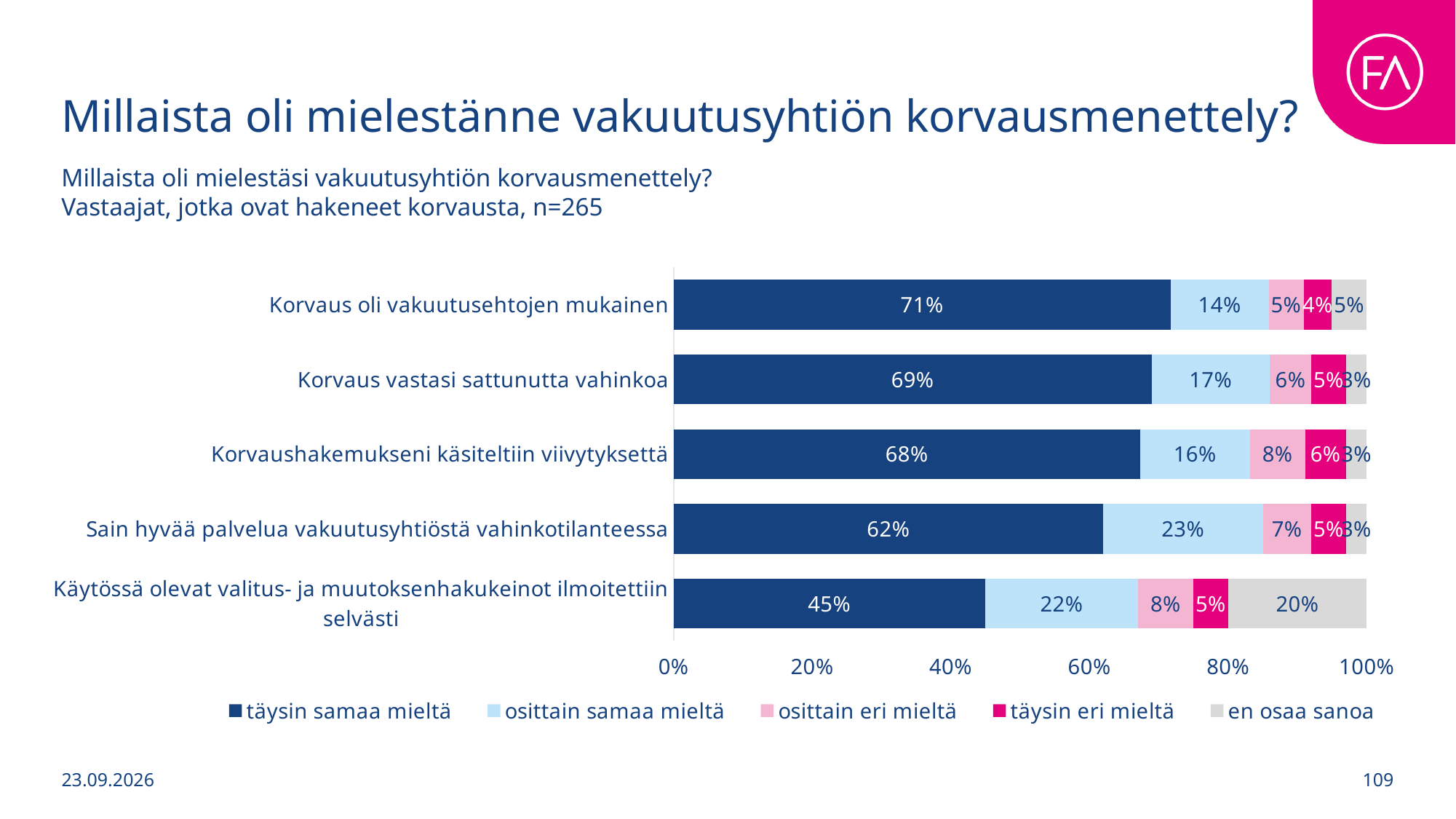
How many categories (statements) are plotted in the chart? 5 What is the 'osittain samaa mieltä' value for 'Sain hyvää palvelua vakuutusyhtiöstä vahinkotilanteessa'? 23% Which is larger: the 'osittain samaa mieltä' value for 'Korvaus vastasi sattunutta vahinkoa' or for 'Sain hyvää palvelua vakuutusyhtiöstä vahinkotilanteessa'? Sain hyvää palvelua vakuutusyhtiöstä vahinkotilanteessa What is the 'en osaa sanoa' value for 'Käytössä olevat valitus- ja muutoksenhakukeinot ilmoitettiin selvästi'? 20% What is the 'osittain eri mieltä' value for 'Korvaushakemukseni käsiteltiin viivytyksettä'? 8% How many series does the legend list? 5 Which statement has the lowest 'täysin samaa mieltä' share? Käytössä olevat valitus- ja muutoksenhakukeinot ilmoitettiin selvästi What colour represents 'täysin eri mieltä' in the legend? magenta (pink-red) What is the 'täysin samaa mieltä' value for 'Korvaus oli vakuutusehtojen mukainen'? 71% What is the difference between the 'täysin samaa mieltä' values for 'Korvaus oli vakuutusehtojen mukainen' and 'Käytössä olevat valitus- ja muutoksenhakukeinot ilmoitettiin selvästi'? 26 percentage points What kind of chart is shown on the slide? stacked bar chart Which statement has the highest 'täysin samaa mieltä' share? Korvaus oli vakuutusehtojen mukainen